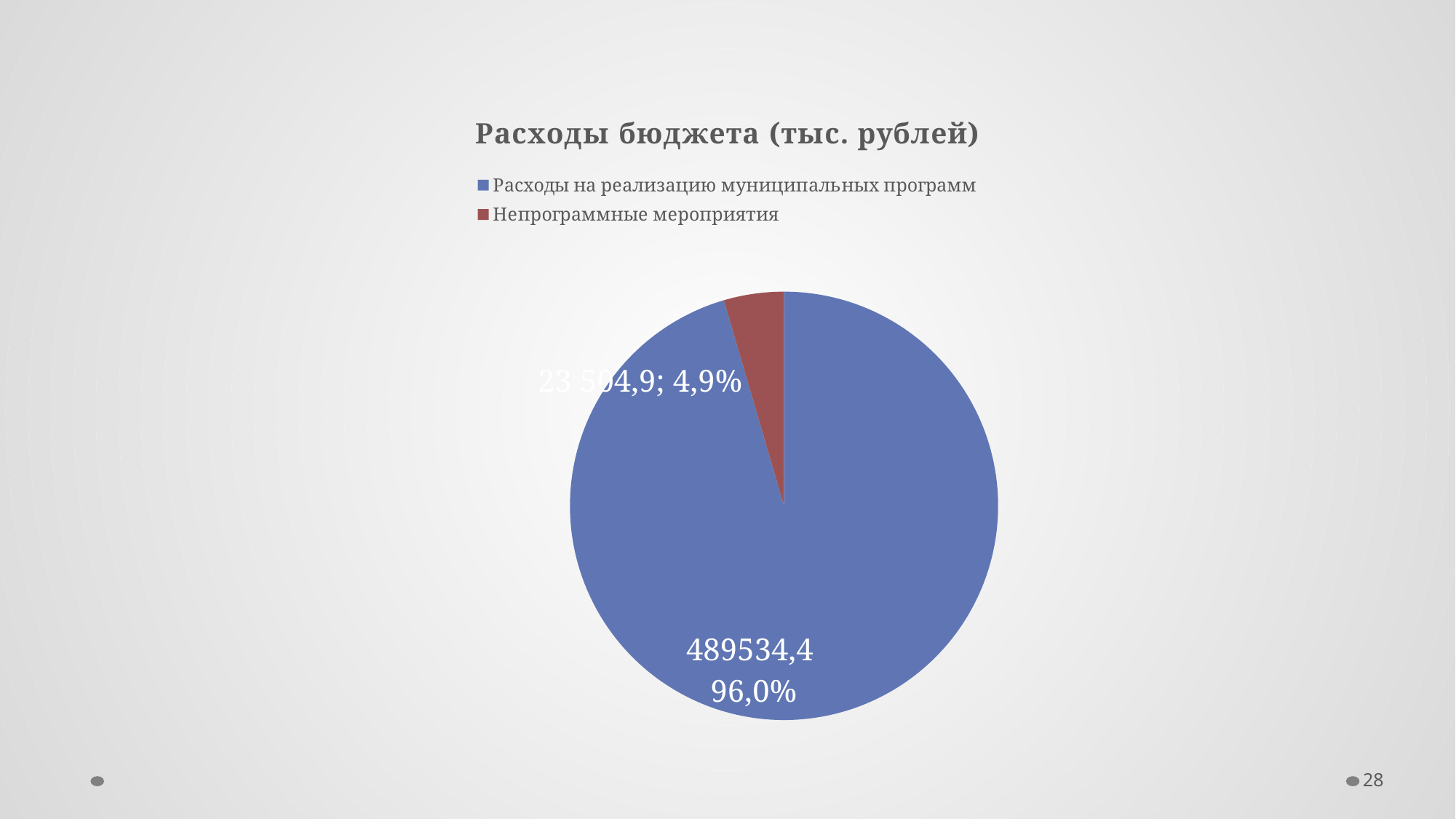
What is the value for Непрограммные мероприятия? 23 504,9 Which category has the smallest slice? Непрограммные мероприятия What share of the pie does Расходы на реализацию муниципальных программ represent? 96,0% What is the value for Расходы на реализацию муниципальных программ? 489534,4 How many slices does the pie chart have? 2 How many series does the legend list? 2 What share of the pie does Непрограммные мероприятия represent? 4,9% What is the difference between the values for Расходы на реализацию муниципальных программ and Непрограммные мероприятия? 466029,5 What kind of chart is shown on the slide? pie chart Which category has the largest slice? Расходы на реализацию муниципальных программ What is the title of the chart? Расходы бюджета (тыс. рублей) Which is larger, Расходы на реализацию муниципальных программ or Непрограммные мероприятия? Расходы на реализацию муниципальных программ